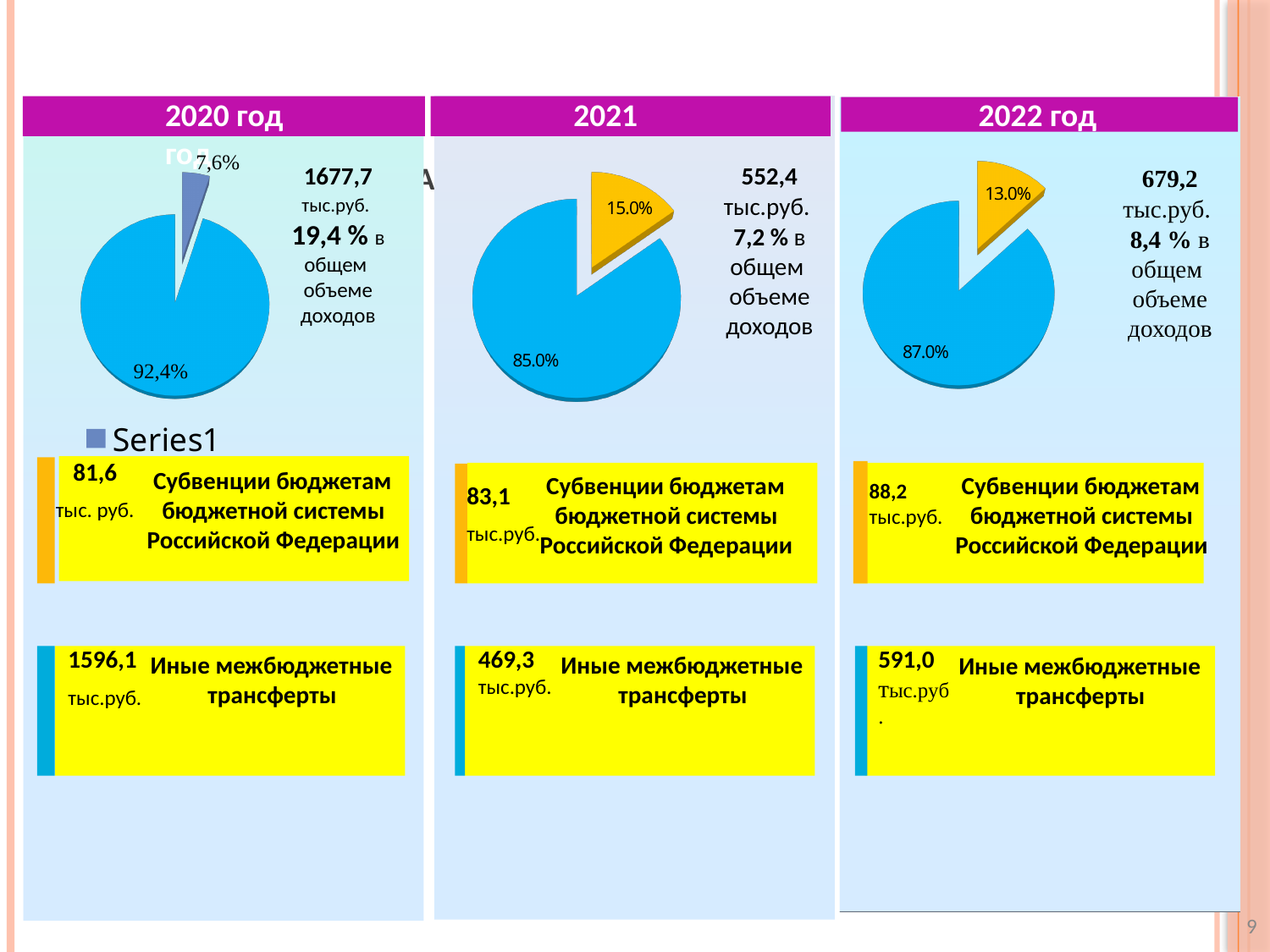
In the 2020 год pie chart, what percentage is shown for the large slice? 92,4% In the 2022 год pie chart, which slice is larger, the orange one or the blue one? the blue one What legend entry is shown below the 2020 год pie chart? Series1 In the 2021 pie chart, what percentage is shown for the blue slice? 85.0% In the 2022 год pie chart, what percentage is shown for the orange slice? 13.0% In the 2020 год pie chart, what percentage is shown for the small slice? 7,6% What kind of chart is shown under the 2020 год heading? pie chart In the 2021 pie chart, what percentage is shown for the orange slice? 15.0% In the 2022 год pie chart, what percentage is shown for the blue slice? 87.0% Which of the three pie charts has the smallest small slice? 2020 год How many slices does the 2021 pie chart have? 2 In the 2021 pie chart, what is the difference between the blue slice's percentage and the orange slice's percentage? 70.0%